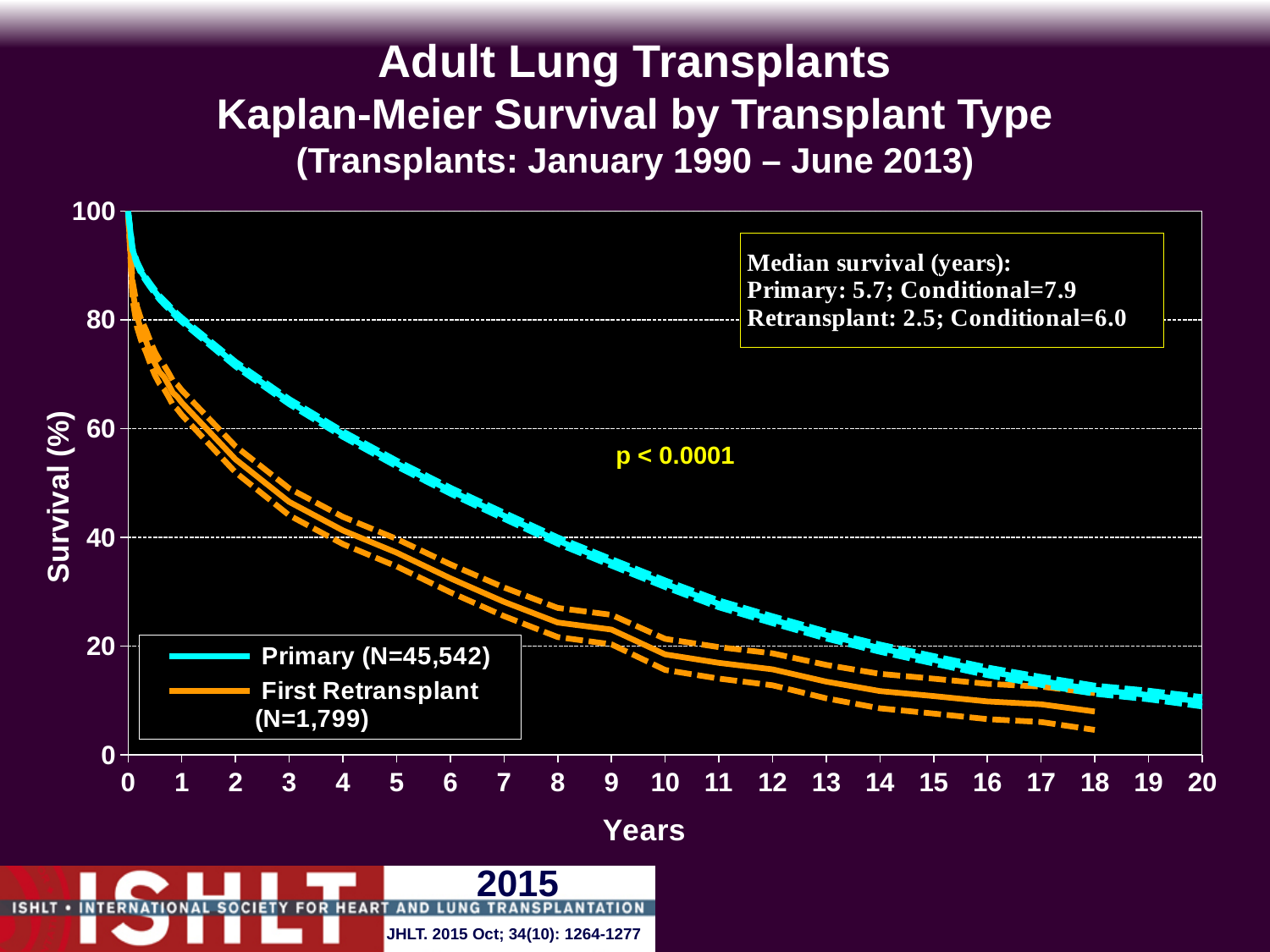
How many series does the legend list? 2 Is the survival for the Primary curve at 5 years greater or less than 60? less What is the N for the First Retransplant group shown in the legend? 1,799 What is the conditional median survival in years for Primary transplants? 7.9 What is the N for the Primary group shown in the legend? 45,542 What is the median survival in years for Primary transplants, as stated in the text box? 5.7 What is the median survival in years for Retransplant, as stated in the text box? 2.5 Which group has the higher median survival, Primary or Retransplant? Primary Do the survival curves rise or fall as years increase? fall Is the survival for the First Retransplant curve at 2 years greater or less than 60? less What kind of chart is shown on the slide? line chart What is the conditional median survival in years for Retransplant? 6.0